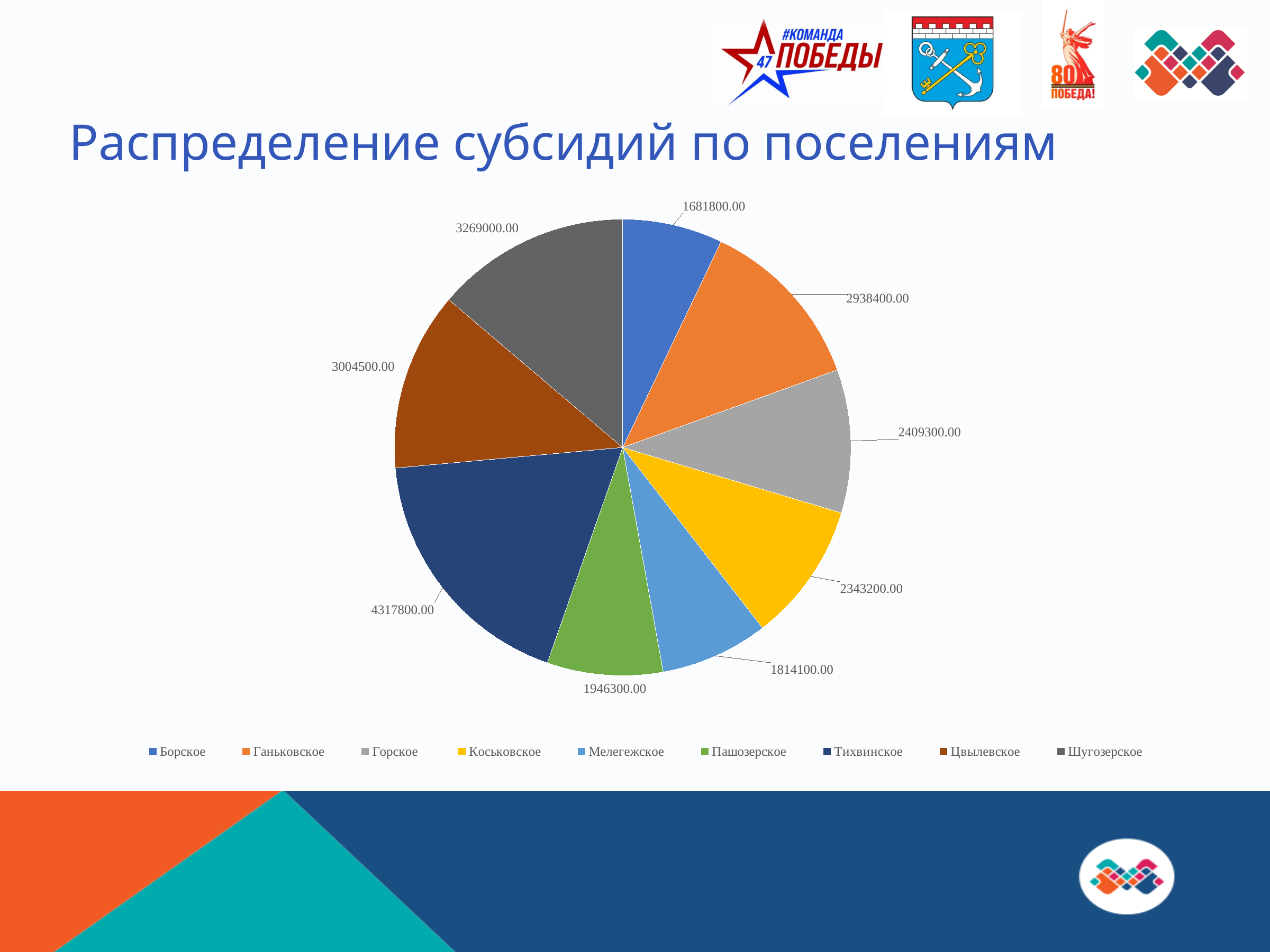
What is the title of the slide? Распределение субсидий по поселениям How many settlements are shown in the pie chart? 9 What is the value for Тихвинское? 4317800.00 Which is larger, the value for Цвылевское or the value for Ганьковское? Цвылевское What is the value for Шугозерское? 3269000.00 Which settlement has the smallest slice of the pie? Борское What is the value for Борское? 1681800.00 What is the difference between the values for Тихвинское and Борское? 2636000.00 What is the difference between the values for Ганьковское and Горское? 529100.00 What is the value for Мелегежское? 1814100.00 Which settlement has the largest slice of the pie? Тихвинское What type of chart is shown on the slide? pie chart